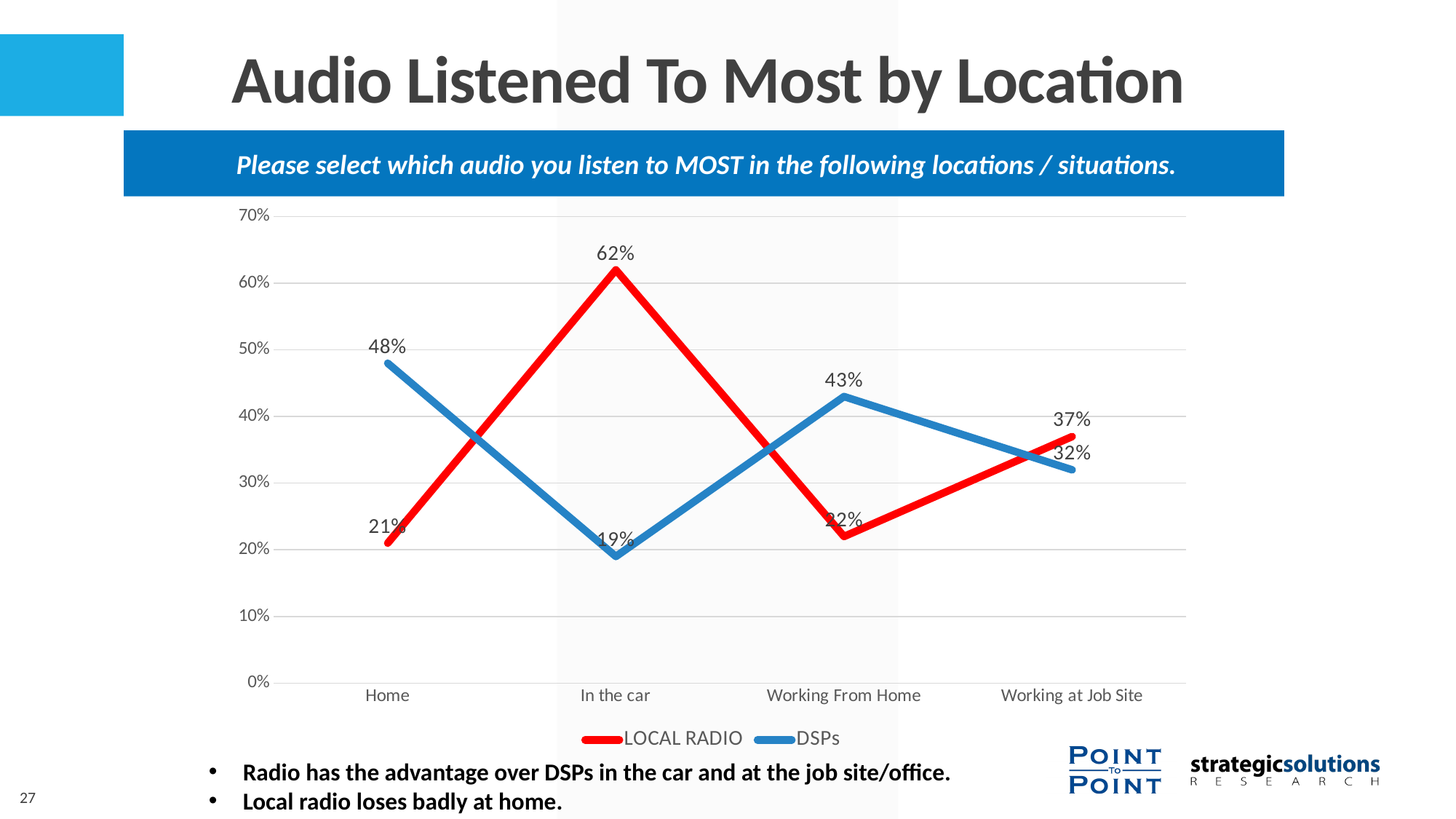
What is the value for DSPs when Working From Home? 43% What is the value for LOCAL RADIO In the car? 62% What is the difference between LOCAL RADIO and DSPs In the car? 43% At which location is the LOCAL RADIO value highest? In the car How many locations are shown on the x axis? 4 What is the value for DSPs at Home? 48% At which location is the DSPs value lowest? In the car What is the value for LOCAL RADIO at Home? 21% What kind of chart is shown on the slide? Line chart What is the value for DSPs when Working at Job Site? 32% How many series does the legend list? 2 Which is larger when Working From Home, LOCAL RADIO or DSPs? DSPs